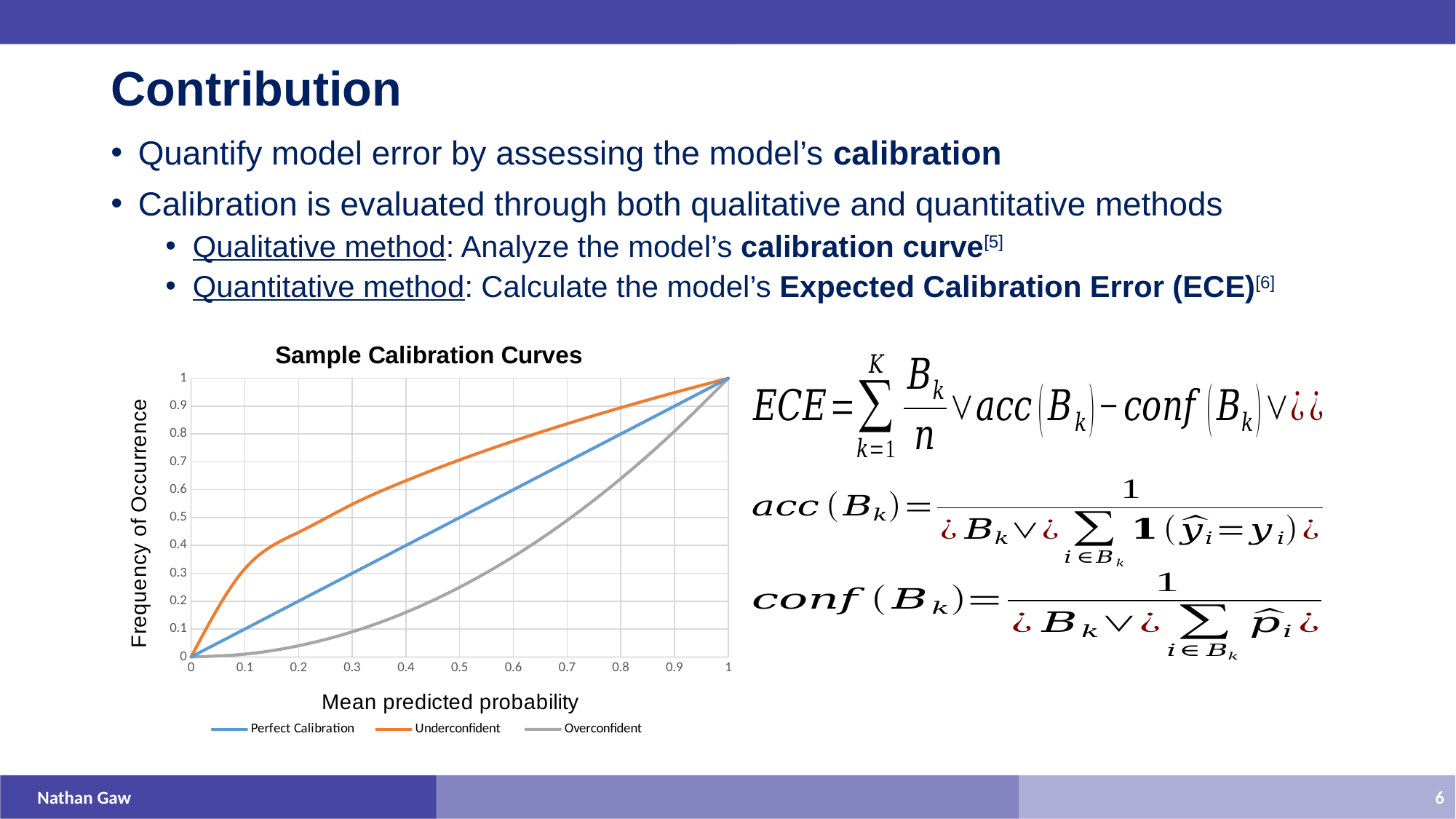
What type of chart is shown under the title "Sample Calibration Curves"? line chart In the "Sample Calibration Curves" chart, which series has the highest value at a mean predicted probability of 0.5? Underconfident In the "Sample Calibration Curves" chart, is the Underconfident value at a mean predicted probability of 0.5 greater or less than 0.6? greater In the "Sample Calibration Curves" chart, do the values of the Overconfident series rise or fall as mean predicted probability increases? rise In the "Sample Calibration Curves" chart, is the Overconfident value at a mean predicted probability of 0.8 greater or less than 0.4? greater In the "Sample Calibration Curves" chart, what is the value of the Perfect Calibration series at a mean predicted probability of 1? 1 In the "Sample Calibration Curves" chart, is the Overconfident value at a mean predicted probability of 0.5 greater or less than 0.3? less In the "Sample Calibration Curves" chart, which series has the lowest value at a mean predicted probability of 0.5? Overconfident How many series does the legend of the "Sample Calibration Curves" chart list? 3 In the "Sample Calibration Curves" chart, at a mean predicted probability of 0.3, which is larger: the Underconfident value or the Overconfident value? Underconfident What is the title of the chart on the slide? Sample Calibration Curves What is the label of the y axis of the "Sample Calibration Curves" chart? Frequency of Occurrence